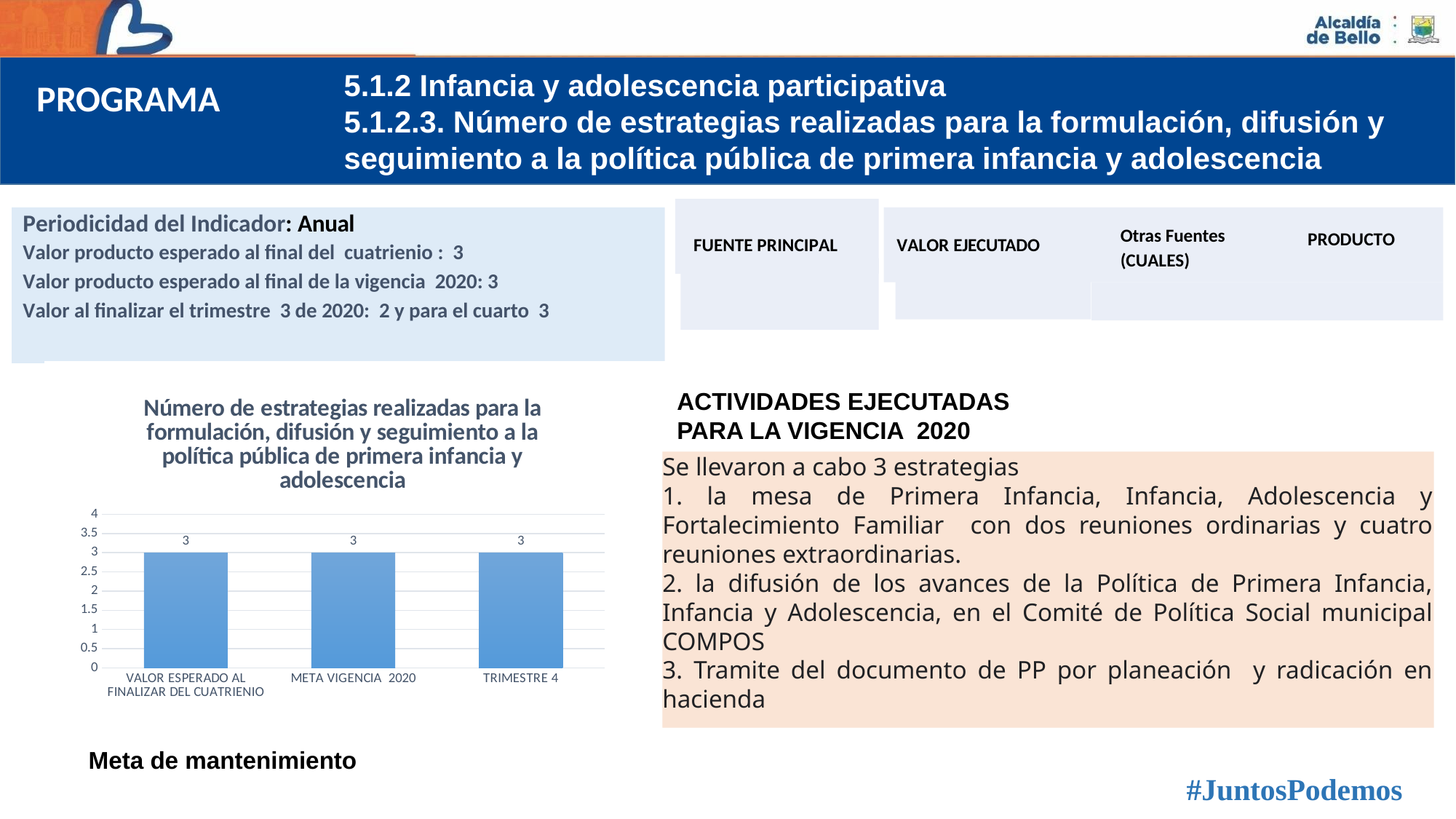
What kind of chart is shown on the slide? bar chart What is the value for VALOR ESPERADO AL FINALIZAR DEL CUATRIENIO? 3 Is the value for VALOR ESPERADO AL FINALIZAR DEL CUATRIENIO greater or less than 4? less Do the values rise, fall, or stay the same across the categories from left to right? stay the same Is the value for TRIMESTRE 4 greater or less than 2? greater What is the difference between the values for META VIGENCIA 2020 and TRIMESTRE 4? 0 What is the value for TRIMESTRE 4? 3 What is the highest value shown on the chart's y axis? 4 What is the value for META VIGENCIA 2020? 3 How many categories are shown on the x axis of the chart? 3 What is the title of the chart? Número de estrategias realizadas para la formulación, difusión y seguimiento a la política pública de primera infancia y adolescencia